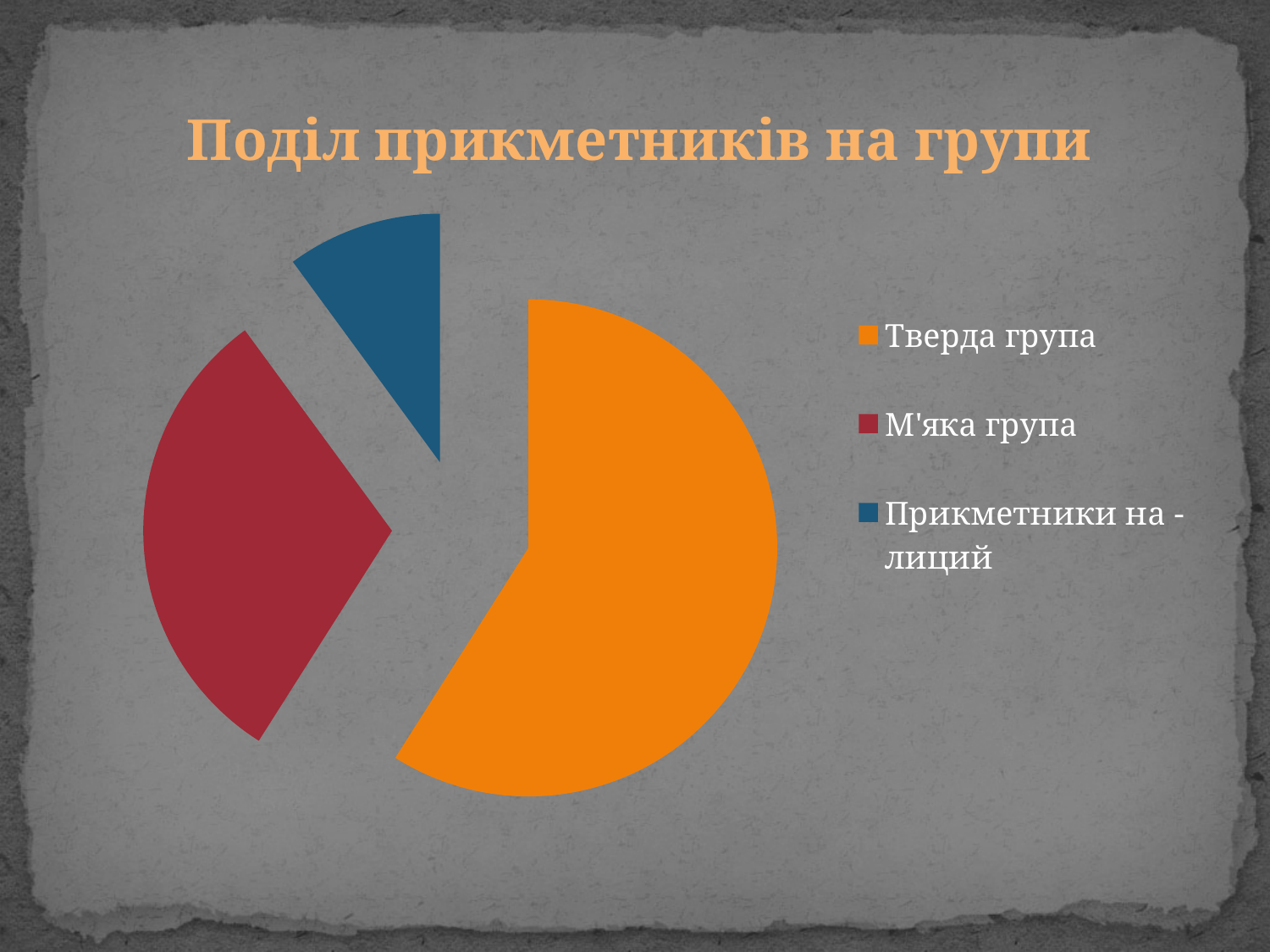
What kind of chart is shown on the slide? pie chart How many slices does the pie chart have? 3 What is the title of the slide with the pie chart? Поділ прикметників на групи How many entries does the legend of the pie chart list? 3 Which slice is larger: Тверда група or М'яка група? Тверда група Which category has the largest slice of the pie chart? Тверда група Which category has the smallest slice of the pie chart? Прикметники на -лиций What colour is the slice for М'яка група in the pie chart? red Which slice is larger: М'яка група or Прикметники на -лиций? М'яка група Which slice is smaller: Тверда група or Прикметники на -лиций? Прикметники на -лиций